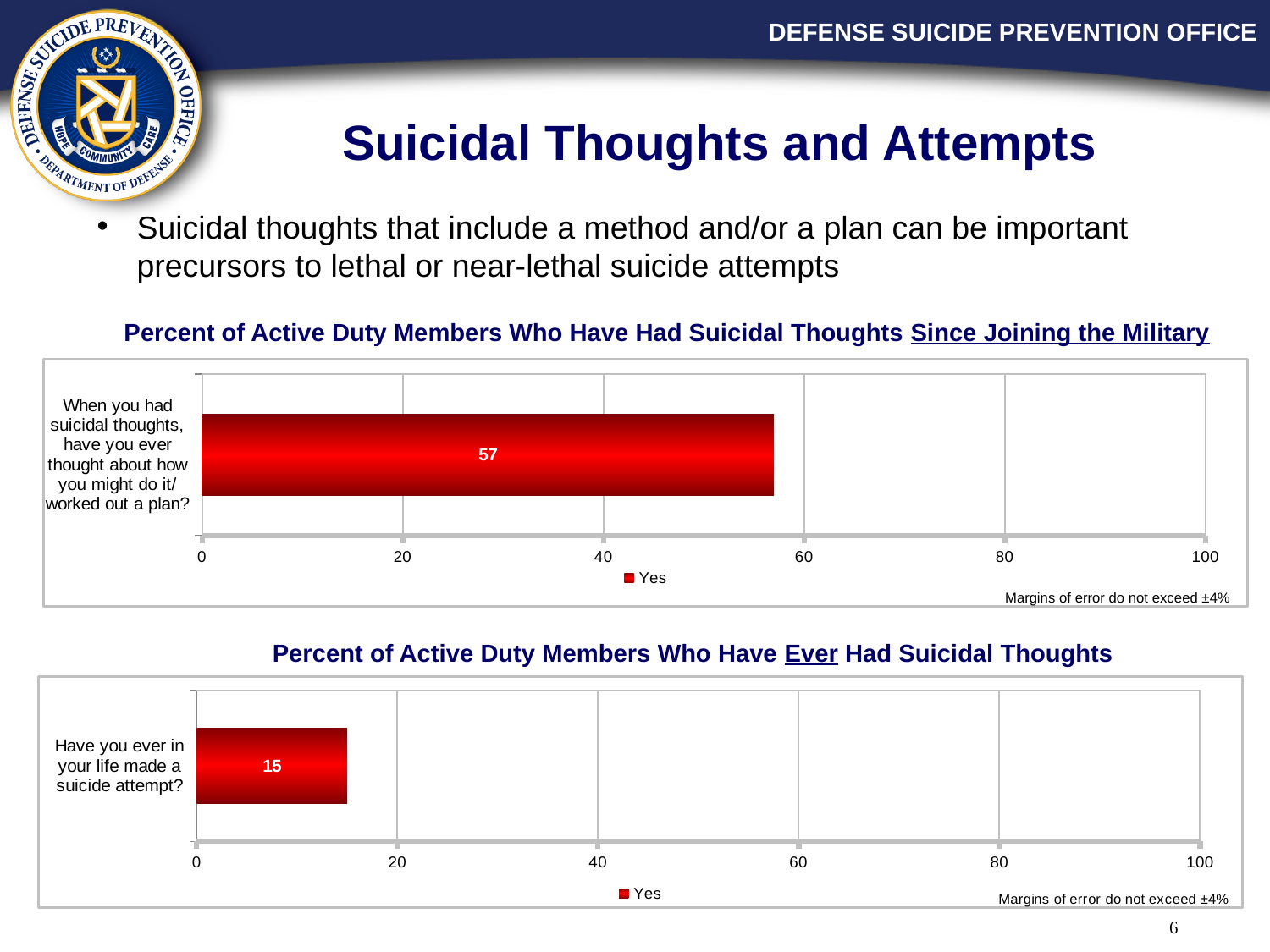
In the bottom chart, is the value for the plotted bar greater or less than 20? less In the top chart (Percent of Active Duty Members Who Have Had Suicidal Thoughts Since Joining the Military), what is the value for "When you had suicidal thoughts, have you ever thought about how you might do it/ worked out a plan?"? 57 What is the difference between the value in the top chart and the value in the bottom chart? 42 What kind of chart is the top chart on the slide? Bar chart In the bottom chart (Percent of Active Duty Members Who Have Ever Had Suicidal Thoughts), what is the value for "Have you ever in your life made a suicide attempt?"? 15 Which is larger: the value in the top chart (57) or the value in the bottom chart (15)? The top chart value (57) What is the maximum value shown on the x axis of the top chart? 100 In the top chart, is the value for the plotted bar greater or less than 40? greater How many bars are plotted in the bottom chart? 1 What kind of chart is the bottom chart on the slide? Bar chart What is the legend entry shown in the bottom chart? Yes How many series does the legend of the top chart list? 1